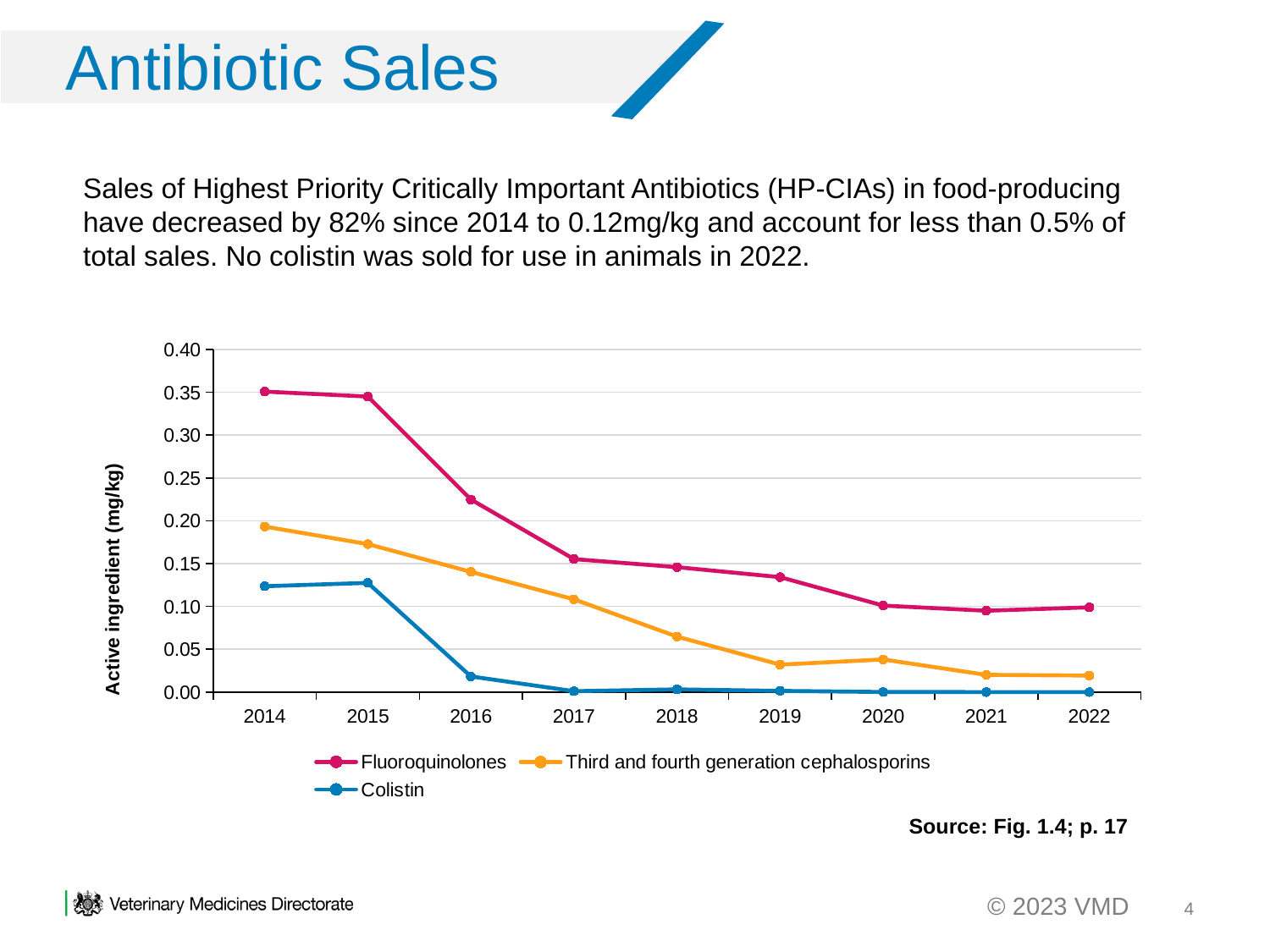
What is the label on the y axis? Active ingredient (mg/kg) Which is larger in 2016: Third and fourth generation cephalosporins or Colistin? Third and fourth generation cephalosporins Which series has the lowest value in 2022? Colistin In which year is the Fluoroquinolones value highest? 2014 Do the Fluoroquinolones values generally rise or fall from 2014 to 2022? Fall Is the value for Third and fourth generation cephalosporins in 2019 greater or less than 0.05? less Is the value for Colistin in 2015 greater or less than 0.10? greater Which series has the highest value in 2014? Fluoroquinolones What kind of chart is shown on the slide? Line chart How many years are plotted along the x axis? 9 Is the value for Fluoroquinolones in 2014 greater or less than 0.30? greater How many series does the legend list? 3